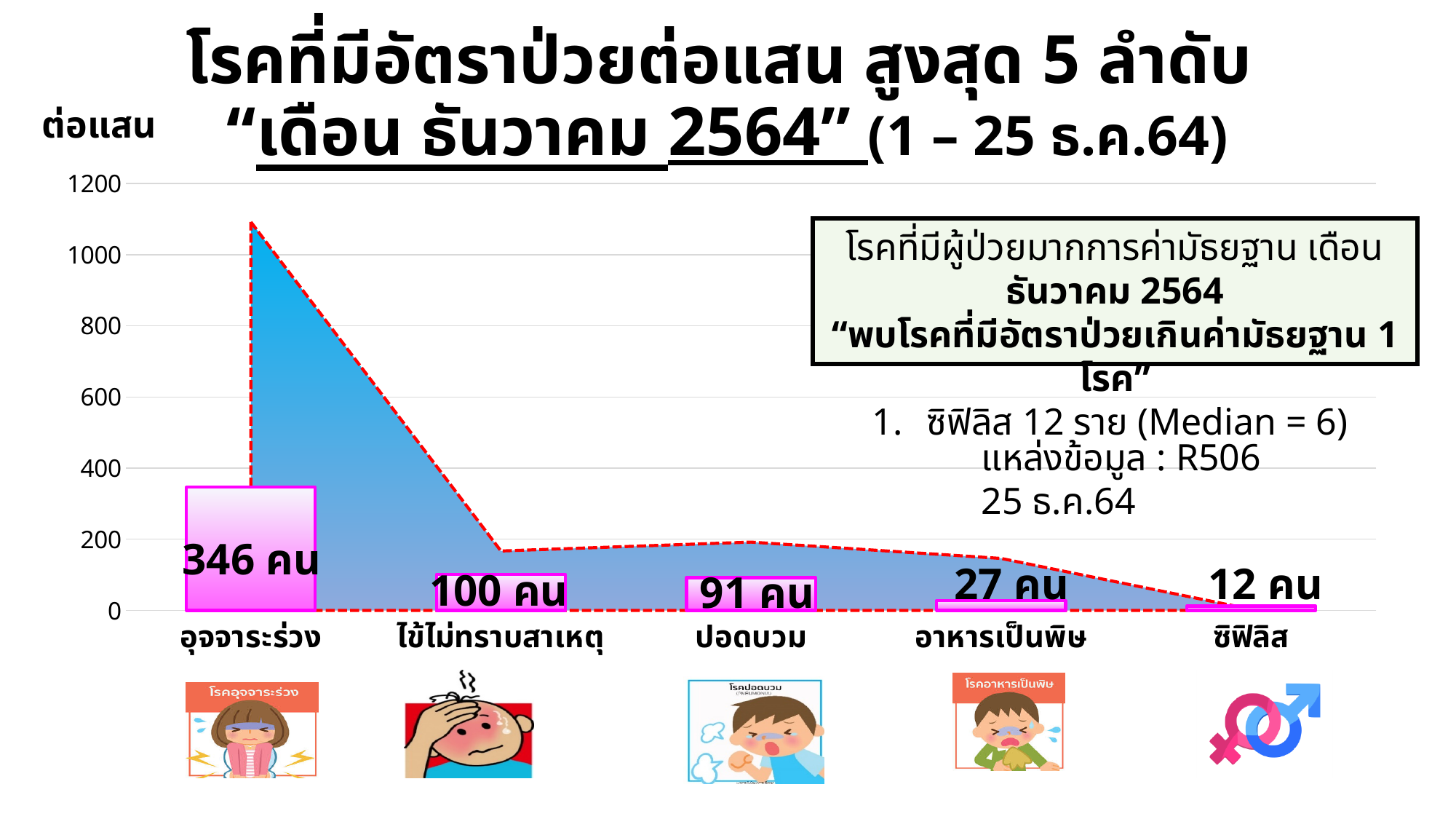
How many cases are shown for ปอดบวม? 91 คน How many cases are shown for ซิฟิลิส? 12 คน Which disease has the lowest rate per 100,000 in the chart? ซิฟิลิส Is the rate per 100,000 for อาหารเป็นพิษ greater or less than 400? less What is the difference in case counts between อาหารเป็นพิษ and ซิฟิลิส? 15 คน How many cases are shown for ไข้ไม่ทราบสาเหตุ? 100 คน How many cases are shown for อุจจาระร่วง? 346 คน How many diseases are shown on the x axis of the chart? 5 Which has more cases, ปอดบวม or อาหารเป็นพิษ? ปอดบวม What is the difference in case counts between อุจจาระร่วง and ไข้ไม่ทราบสาเหตุ? 246 คน Which disease has the highest rate per 100,000 in the chart? อุจจาระร่วง